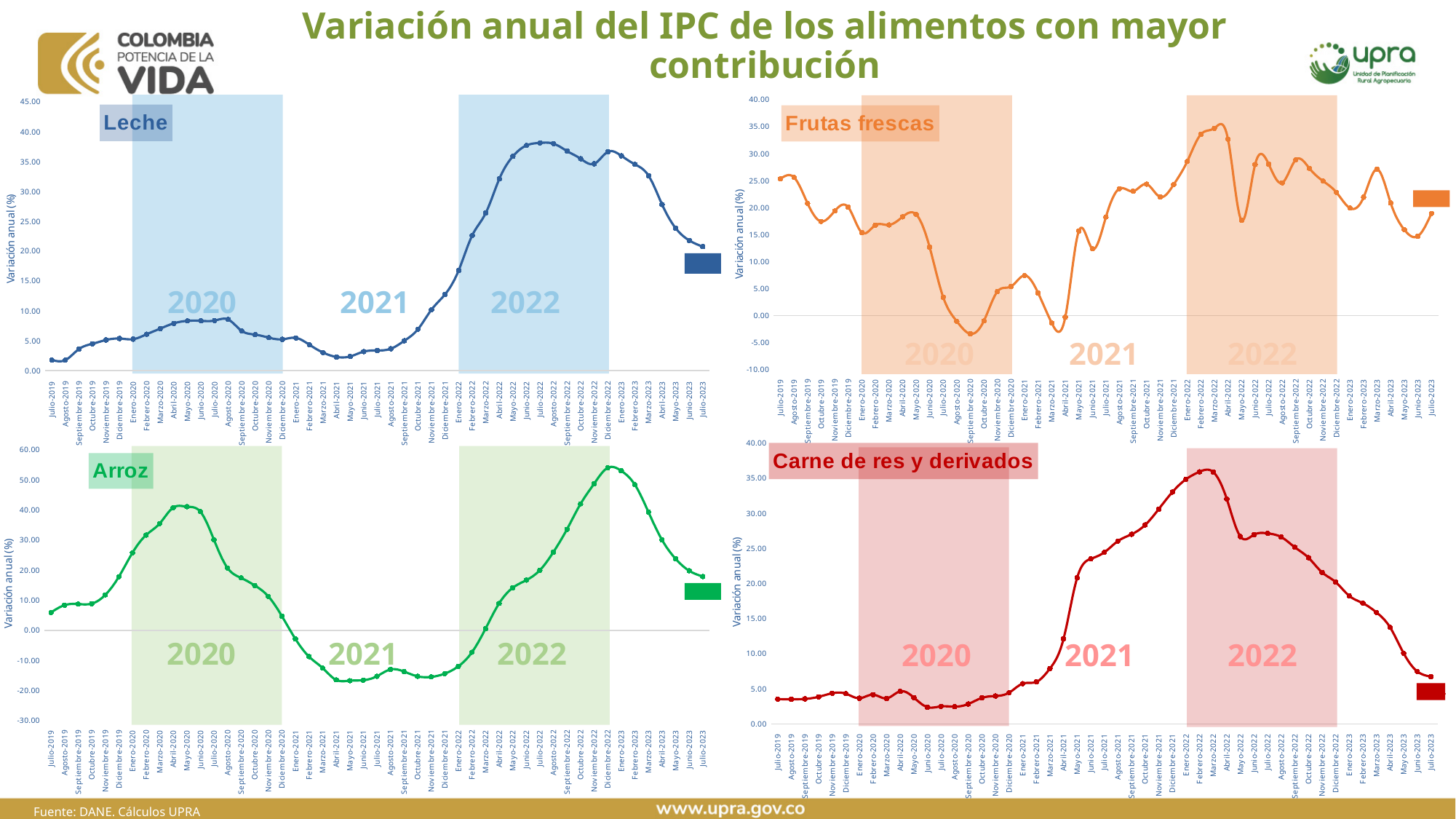
In the Frutas frescas chart, is the value for Septiembre-2020 greater or less than 0? less In the Arroz chart, is the value for Enero-2023 greater or less than 50? greater In the Frutas frescas chart, is the value for Marzo-2022 greater or less than 30? greater What kind of chart is the Leche chart? line chart In the Leche chart, which is larger, the value for Julio-2022 or the value for Julio-2019? Julio-2022 What is the label on the vertical axis of the Arroz chart? Variación anual (%) In the Carne de res y derivados chart, do the values rise or fall from Julio-2019 to Marzo-2022? rise